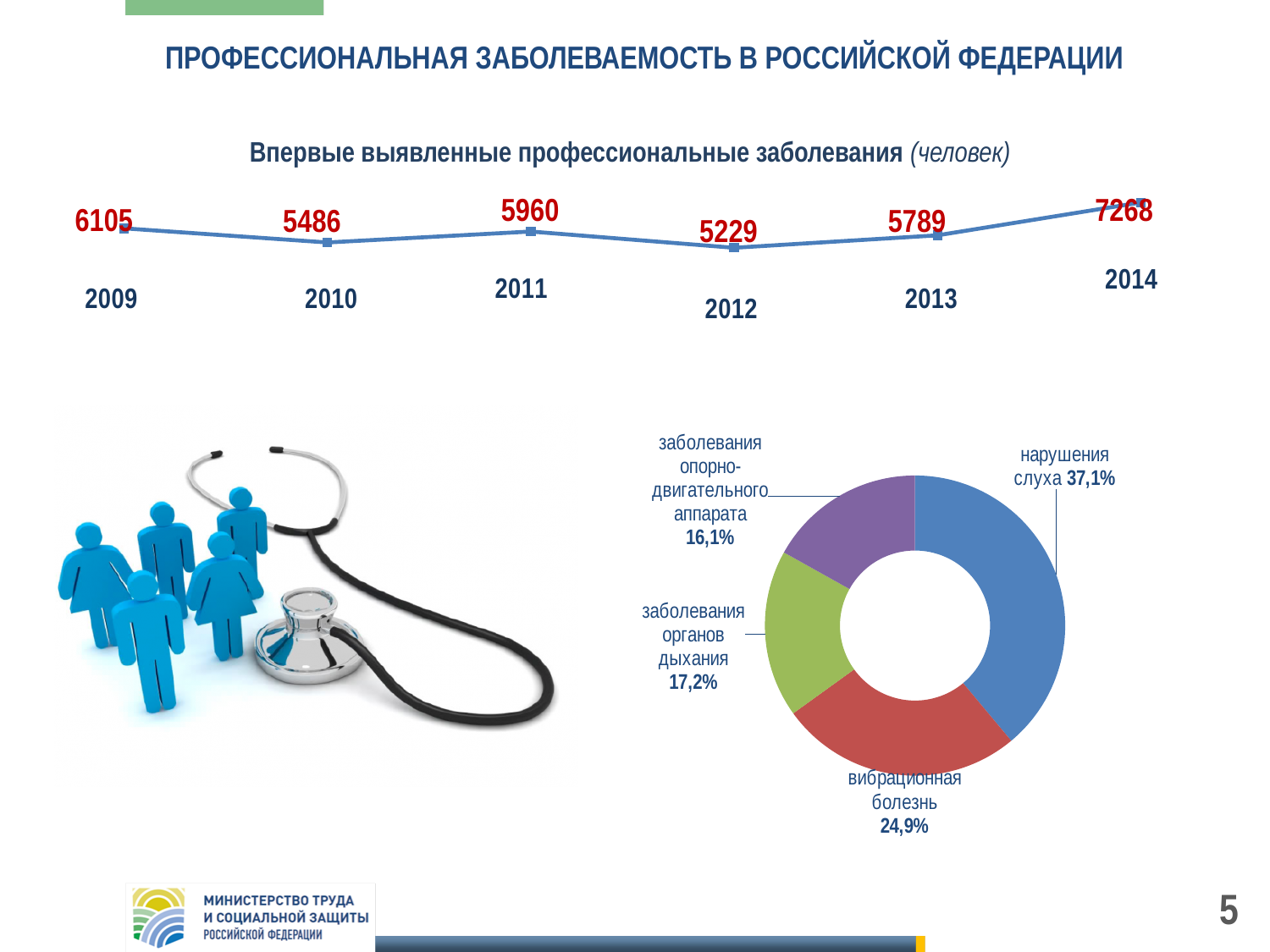
What kind of chart is the top chart 'Впервые выявленные профессиональные заболевания'? line chart In the line chart 'Впервые выявленные профессиональные заболевания', what is the value for 2012? 5229 In the line chart 'Впервые выявленные профессиональные заболевания', does the value rise or fall from 2013 to 2014? rise How many slices does the doughnut chart at the bottom right have? 4 In the line chart 'Впервые выявленные профессиональные заболевания', which year has the lowest value? 2012 How many years are plotted in the line chart 'Впервые выявленные профессиональные заболевания'? 6 In the line chart 'Впервые выявленные профессиональные заболевания', what is the difference between the values for 2014 and 2013? 1479 In the line chart 'Впервые выявленные профессиональные заболевания', which year has the highest value? 2014 In the doughnut chart at the bottom right, which category has the largest share? нарушения слуха In the line chart 'Впервые выявленные профессиональные заболевания', which is larger: the value for 2009 or the value for 2011? 2009 In the line chart 'Впервые выявленные профессиональные заболевания', what is the value for 2014? 7268 In the doughnut chart at the bottom right, what share is 'вибрационная болезнь'? 24,9%